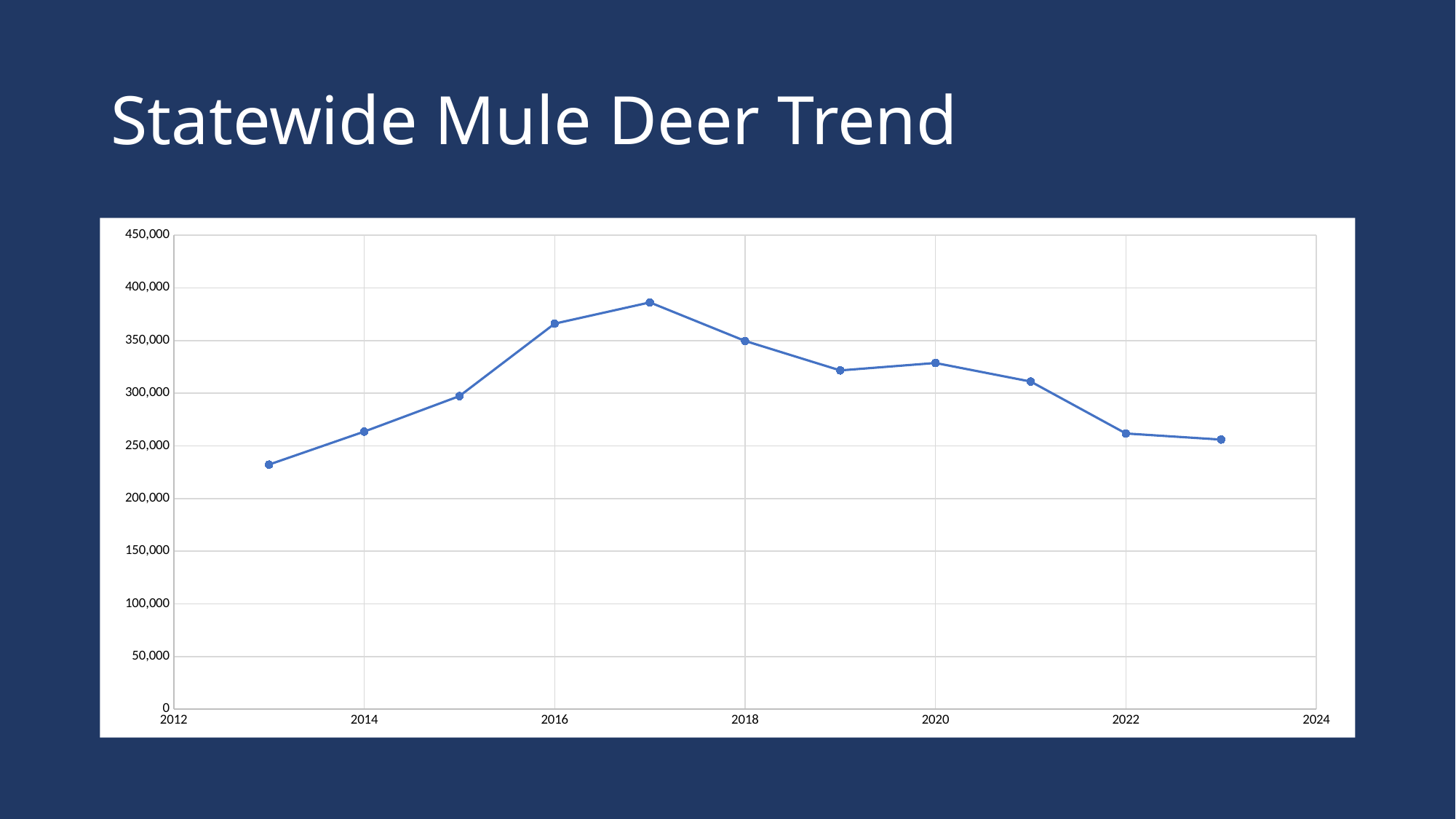
Which year has the larger value, 2016 or 2018? 2016 In which year is the plotted value highest? 2017 Is the value for 2019 greater or less than 300,000? greater Is the value for 2017 greater or less than 350,000? greater In which year is the plotted value lowest? 2013 Is the value for 2016 greater or less than 350,000? greater What is the title of the slide? Statewide Mule Deer Trend Do the values rise or fall from 2013 to 2017? rise Which year has the larger value, 2013 or 2023? 2023 How many data points are plotted on the line? 11 What kind of chart is shown on the slide? line chart